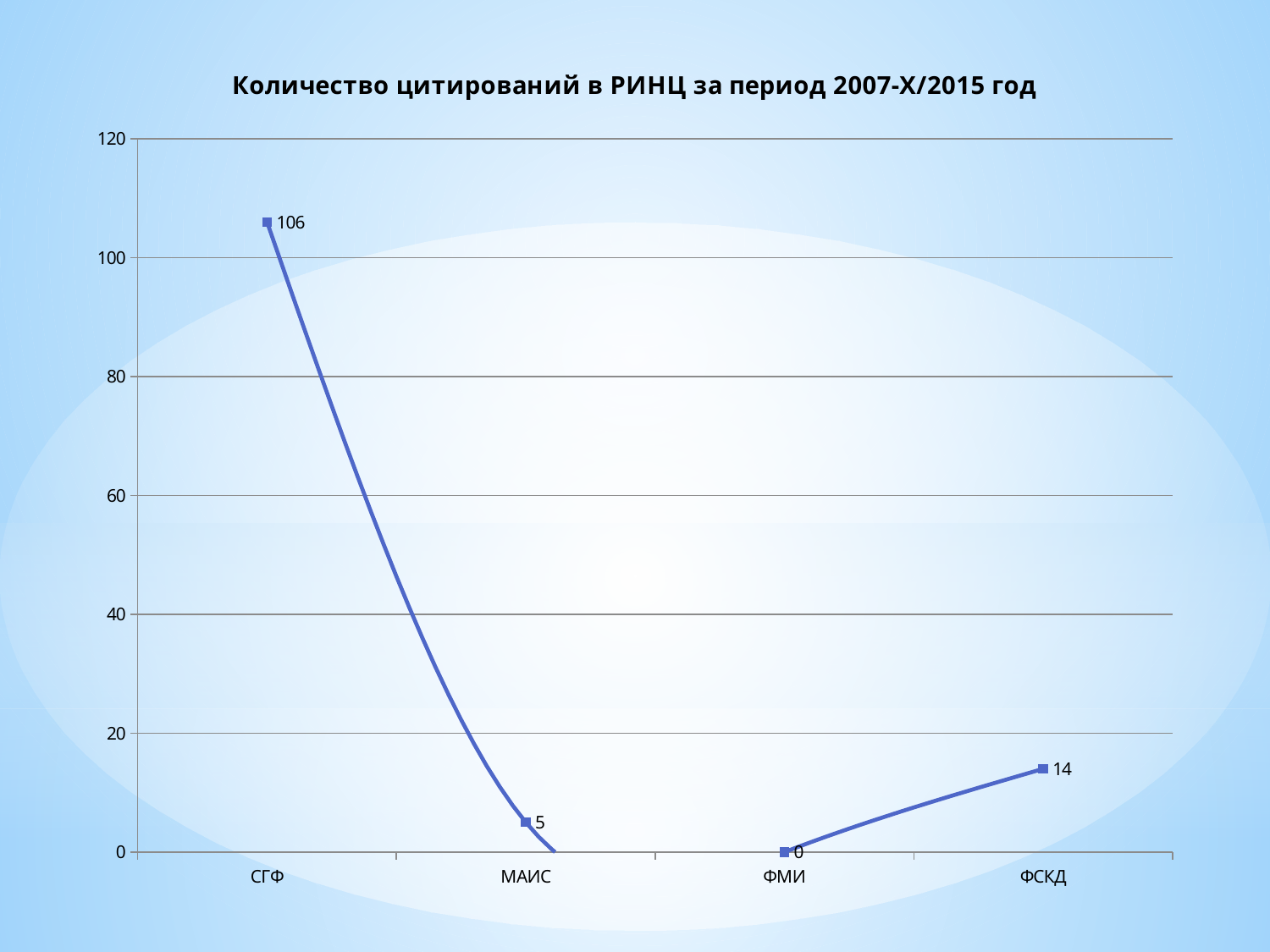
What is the value for ФСКД? 14 How many categories are shown on the x axis? 4 What is the title of the chart? Количество цитирований в РИНЦ за период 2007-X/2015 год What kind of chart is this? line chart Is the value for СГФ greater or less than 100? greater Which category has the lowest value? ФМИ What is the difference between the values for СГФ and ФСКД? 92 What is the value for СГФ? 106 What is the value for МАИС? 5 Which is larger, the value for МАИС or the value for ФСКД? ФСКД What is the value for ФМИ? 0 Which category has the highest value? СГФ